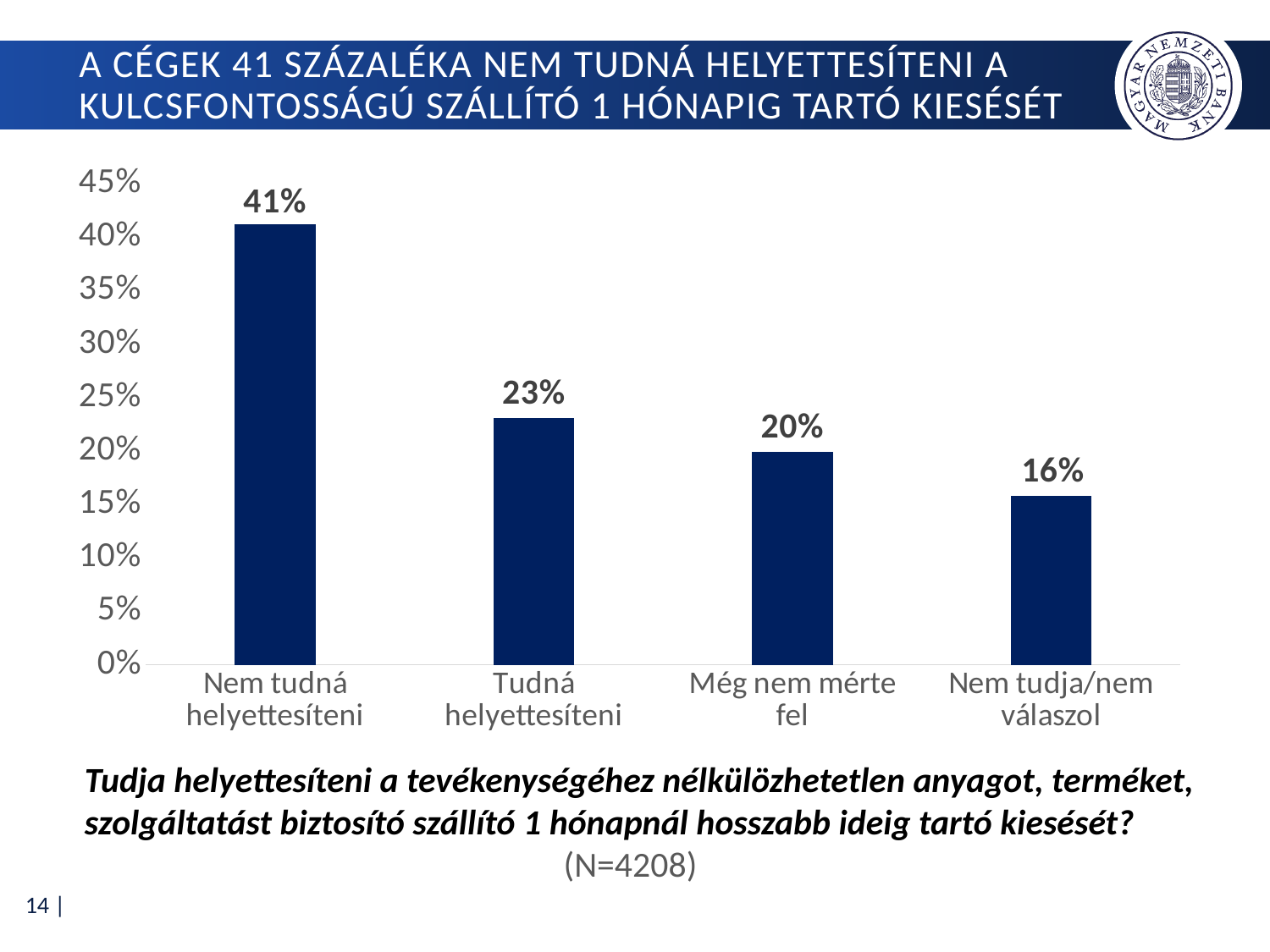
What kind of chart is shown on the slide? bar chart What is the sample size (N) stated below the chart? N=4208 What is the value for "Még nem mérte fel"? 20% What is the value for "Nem tudná helyettesíteni"? 41% Is the value for "Tudná helyettesíteni" greater or less than 25%? less What is the value for "Nem tudja/nem válaszol"? 16% Which is larger, the value for "Még nem mérte fel" or the value for "Nem tudja/nem válaszol"? Még nem mérte fel What is the difference between the values for "Nem tudná helyettesíteni" and "Tudná helyettesíteni"? 18% Which category has the lowest value? Nem tudja/nem válaszol How many categories are shown on the chart? 4 What is the value for "Tudná helyettesíteni"? 23% Which category has the highest value? Nem tudná helyettesíteni